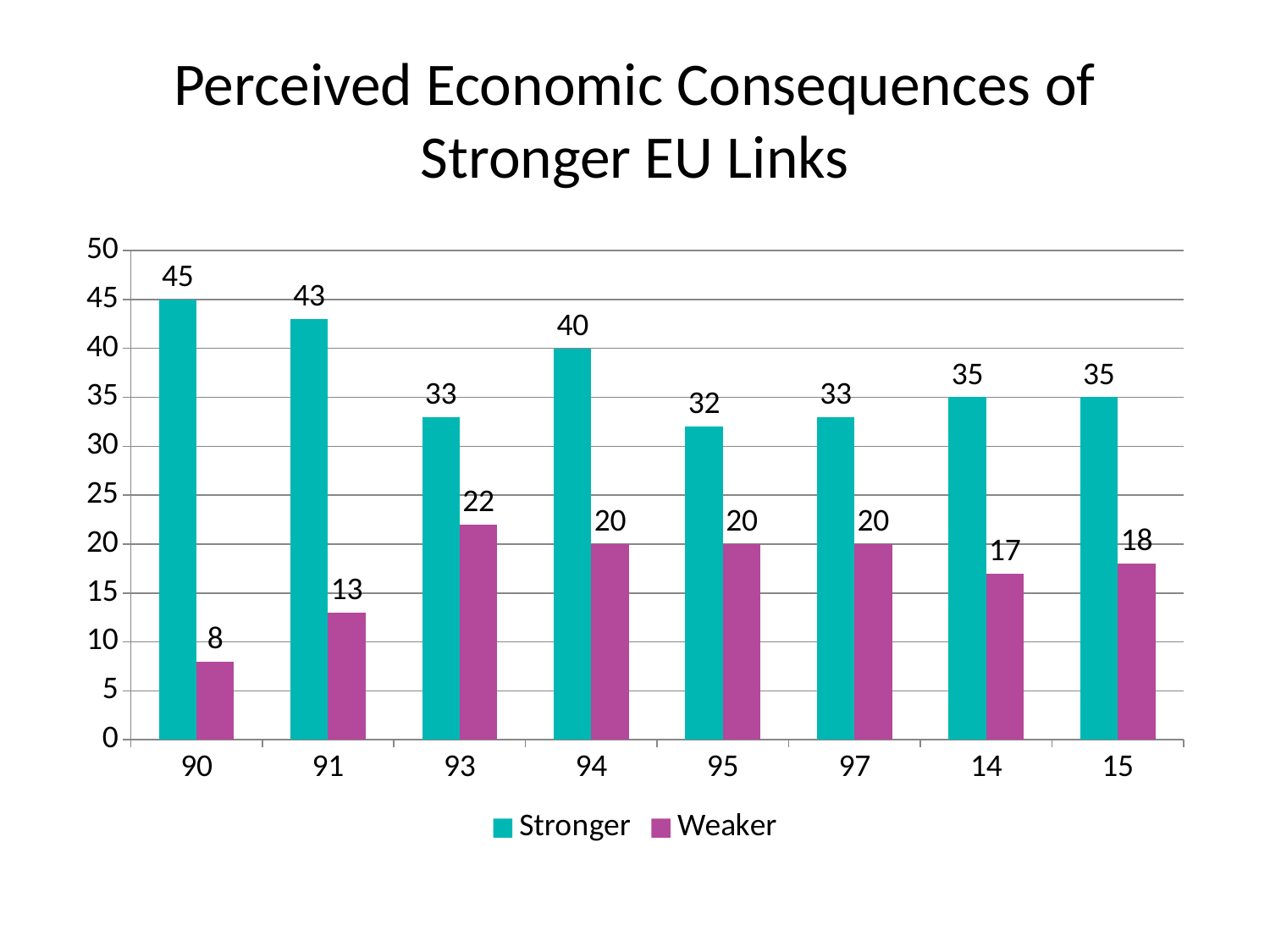
What is the value for Weaker in category 93? 22 How many categories are shown on the x axis? 8 What is the title of the chart? Perceived Economic Consequences of Stronger EU Links What is the value for Weaker in category 14? 17 What colour are the Weaker bars? Purple What kind of chart is shown on the slide? Bar chart Which category has the highest Stronger value? 90 What is the difference between the Stronger and Weaker values in category 91? 30 Which category has the lowest Weaker value? 90 Which is larger in category 95: the Stronger value or the Weaker value? Stronger How many series does the legend list? 2 What is the value for Stronger in category 90? 45